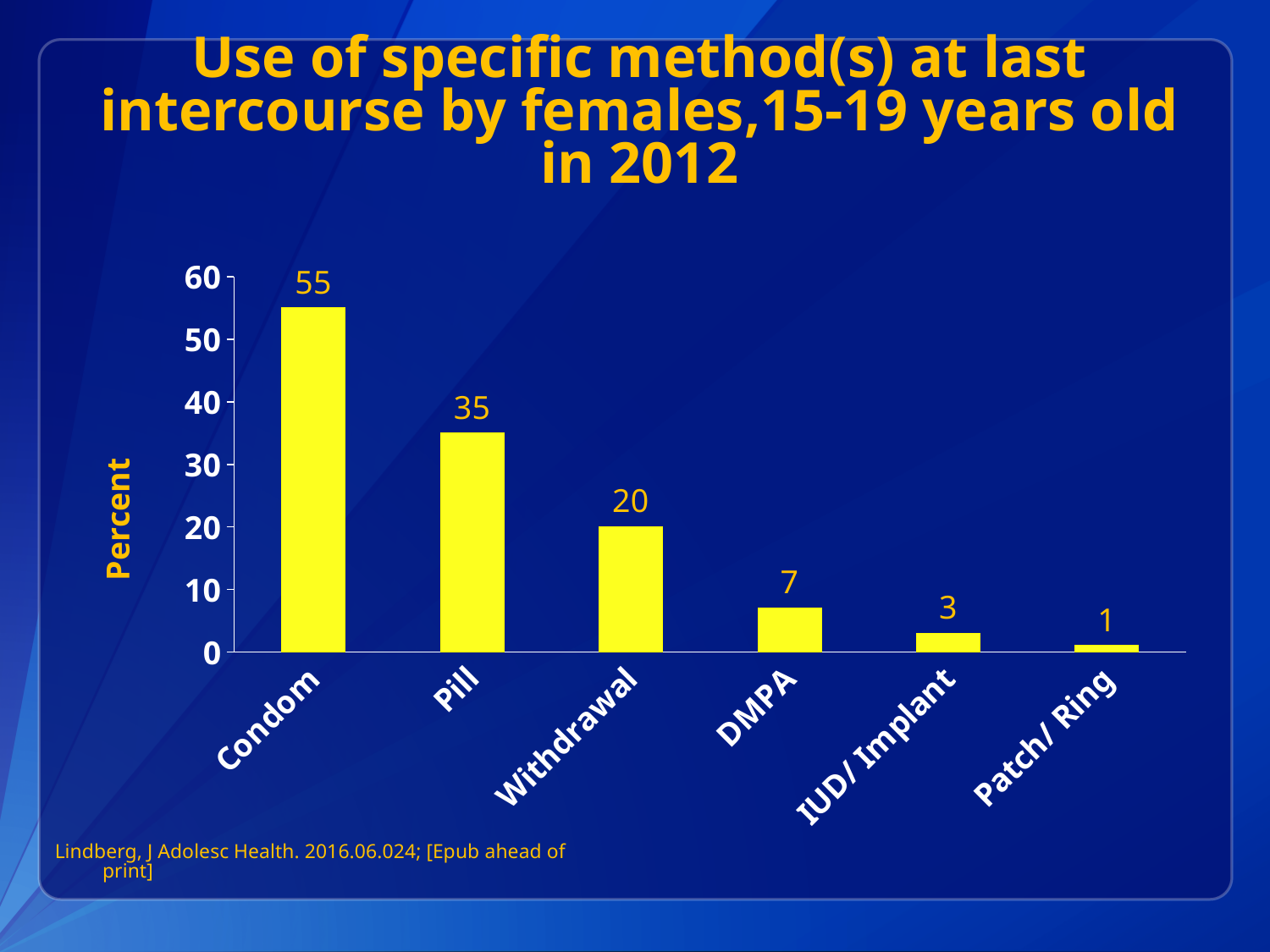
What is the label of the y axis? Percent How many methods are shown on the x axis? 6 Which method has the highest value? Condom What is the value for Condom? 55 Which is larger, the value for Pill or the value for Withdrawal? Pill What kind of chart is shown on the slide? bar chart Is the value for Pill greater or less than 30? greater What is the difference between the values for Withdrawal and DMPA? 13 Which method has the lowest value? Patch/ Ring What is the value for IUD/ Implant? 3 What is the difference between the values for Condom and Pill? 20 What is the value for Withdrawal? 20